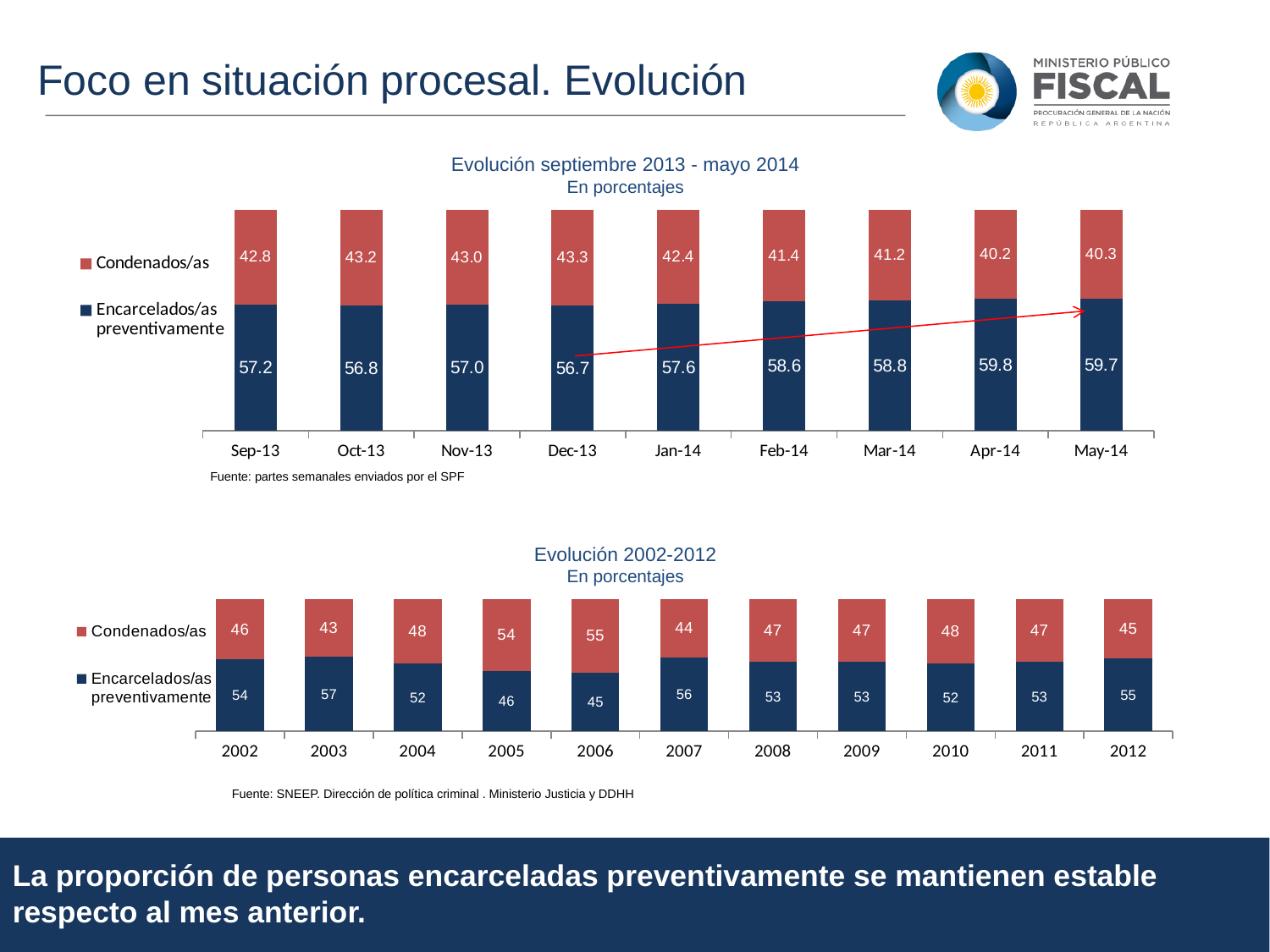
In the chart 'Evolución 2002-2012', which year has the highest value for Condenados/as? 2006 In the chart 'Evolución septiembre 2013 - mayo 2014', what is the value for Condenados/as in May-14? 40.3 In the chart 'Evolución septiembre 2013 - mayo 2014', which month has the highest value for Encarcelados/as preventivamente? Apr-14 In the chart 'Evolución septiembre 2013 - mayo 2014', which month has the lowest value for Condenados/as? Apr-14 In the chart 'Evolución septiembre 2013 - mayo 2014', how many months are shown on the x axis? 9 In the chart 'Evolución septiembre 2013 - mayo 2014', does the Encarcelados/as preventivamente value generally rise or fall from Dec-13 to Apr-14? rise In the chart 'Evolución 2002-2012', how many series does the legend list? 2 What kind of chart is 'Evolución 2002-2012'? stacked bar chart In the chart 'Evolución septiembre 2013 - mayo 2014', what is the difference between the Encarcelados/as preventivamente values for May-14 and Sep-13? 2.5 In the chart 'Evolución septiembre 2013 - mayo 2014', what is the value for Encarcelados/as preventivamente in Dec-13? 56.7 In the chart 'Evolución 2002-2012', which is larger, the Encarcelados/as preventivamente value for 2003 or for 2005? 2003 In the chart 'Evolución 2002-2012', what is the value for Encarcelados/as preventivamente in 2006? 45